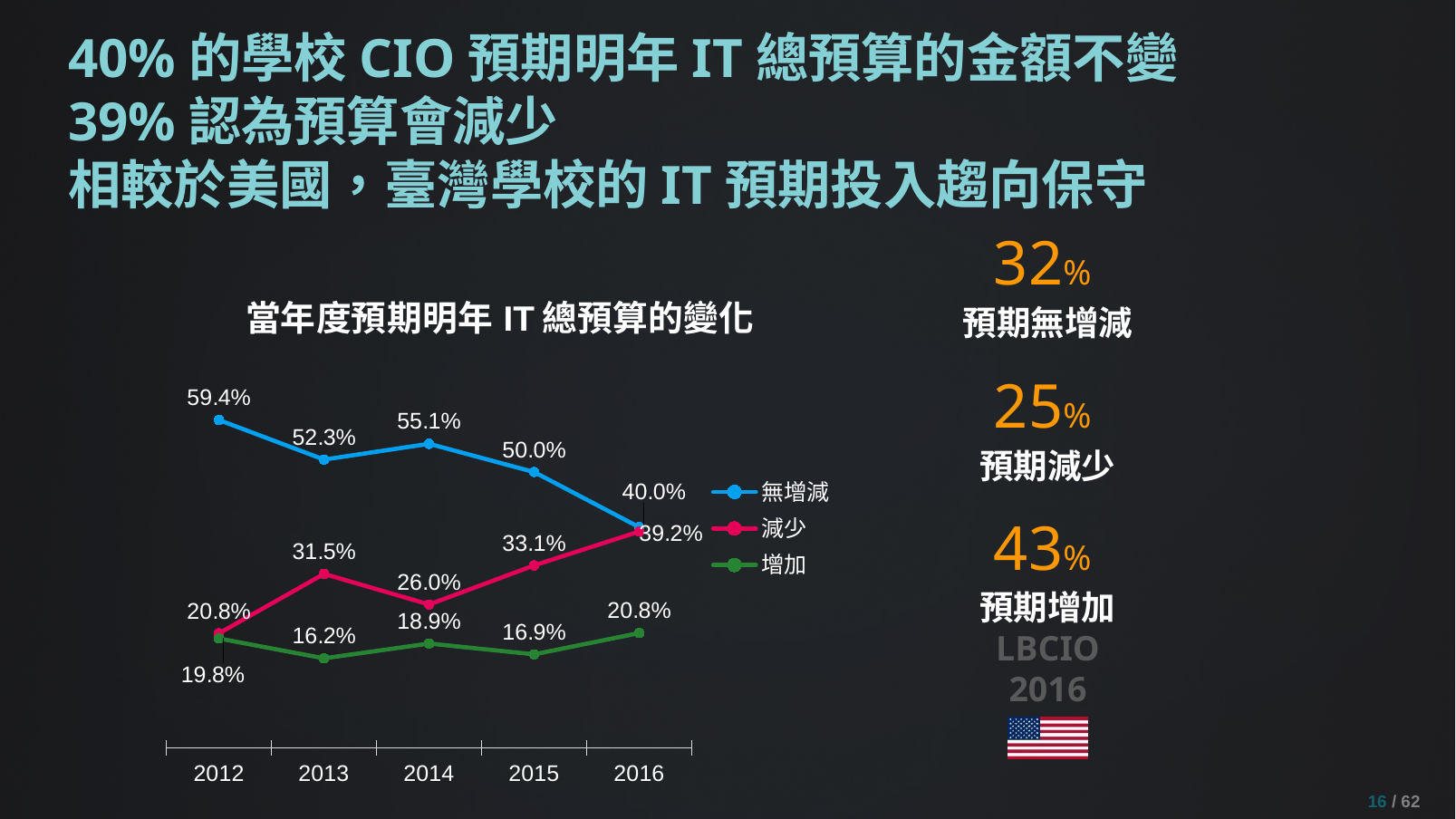
In which year is 無增減 at its lowest? 2016 How many years are shown on the x axis of the chart? 5 What is the value of 增加 in 2013? 16.2% Which is larger in 2014: 減少 or 增加? 減少 What is the title of the chart? 當年度預期明年 IT 總預算的變化 Does the 無增減 series generally rise or fall from 2012 to 2016? fall What is the value of 減少 in 2016? 39.2% How many series does the chart legend list? 3 What type of chart is shown on the slide? line chart In which year is 減少 at its highest? 2016 What is the value of 無增減 in 2012? 59.4% What is the difference between 無增減 in 2012 and 無增減 in 2016? 19.4%